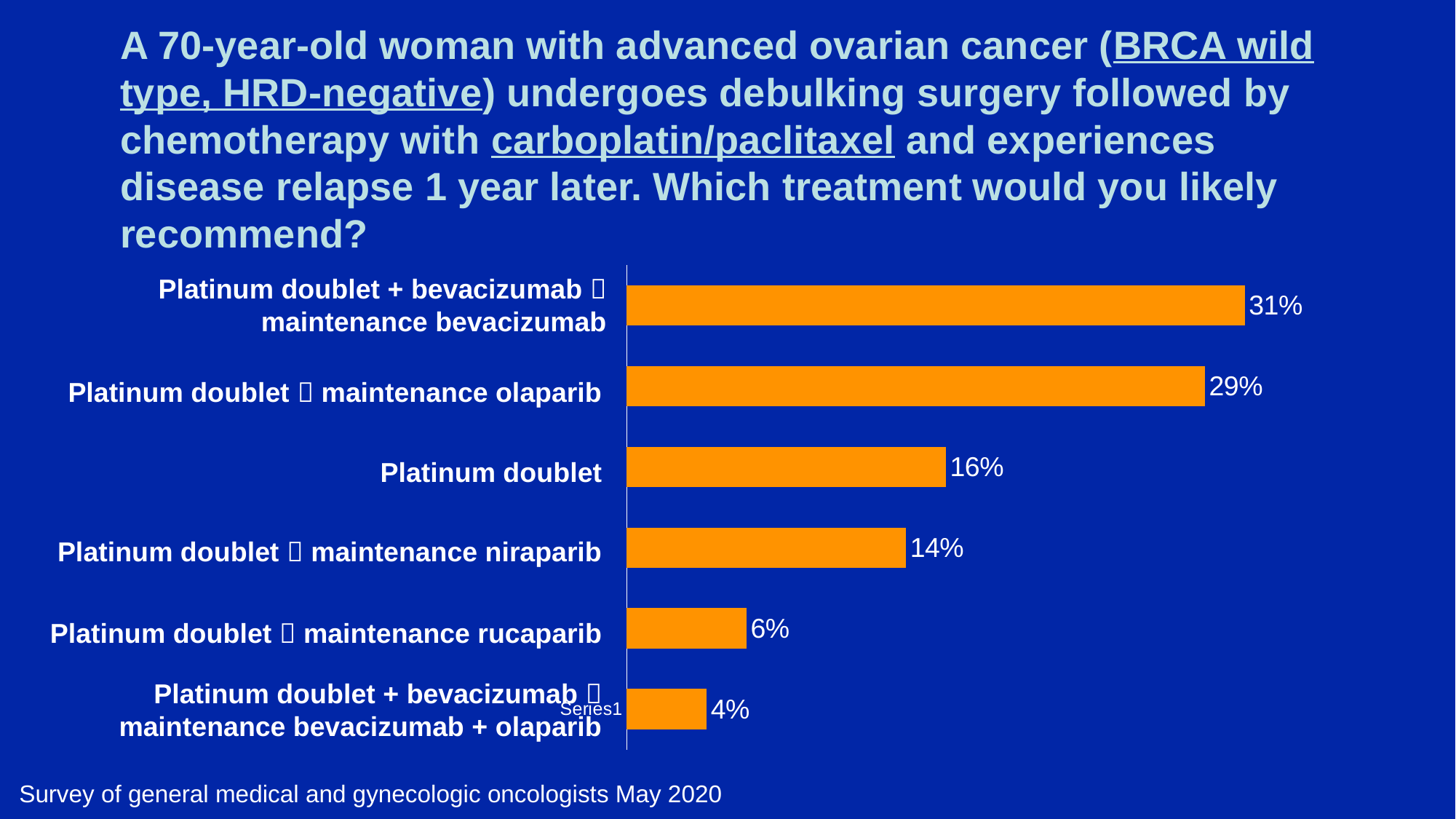
Which treatment option received the highest percentage of responses? Platinum doublet + bevacizumab → maintenance bevacizumab Which has a larger value: Platinum doublet or Platinum doublet → maintenance rucaparib? Platinum doublet What is the value for Platinum doublet → maintenance rucaparib? 6% What percentage of respondents chose Platinum doublet → maintenance olaparib? 29% What is the value for Platinum doublet → maintenance niraparib? 14% What colour are the bars in the chart? Orange What is the value for Platinum doublet alone? 16% How many treatment options are shown in the chart? 6 What is the difference in percentage points between Platinum doublet → maintenance olaparib and Platinum doublet → maintenance niraparib? 15 What type of chart is shown on the slide? Bar chart What percentage of respondents chose Platinum doublet + bevacizumab → maintenance bevacizumab? 31% Which treatment option received the lowest percentage of responses? Platinum doublet + bevacizumab → maintenance bevacizumab + olaparib